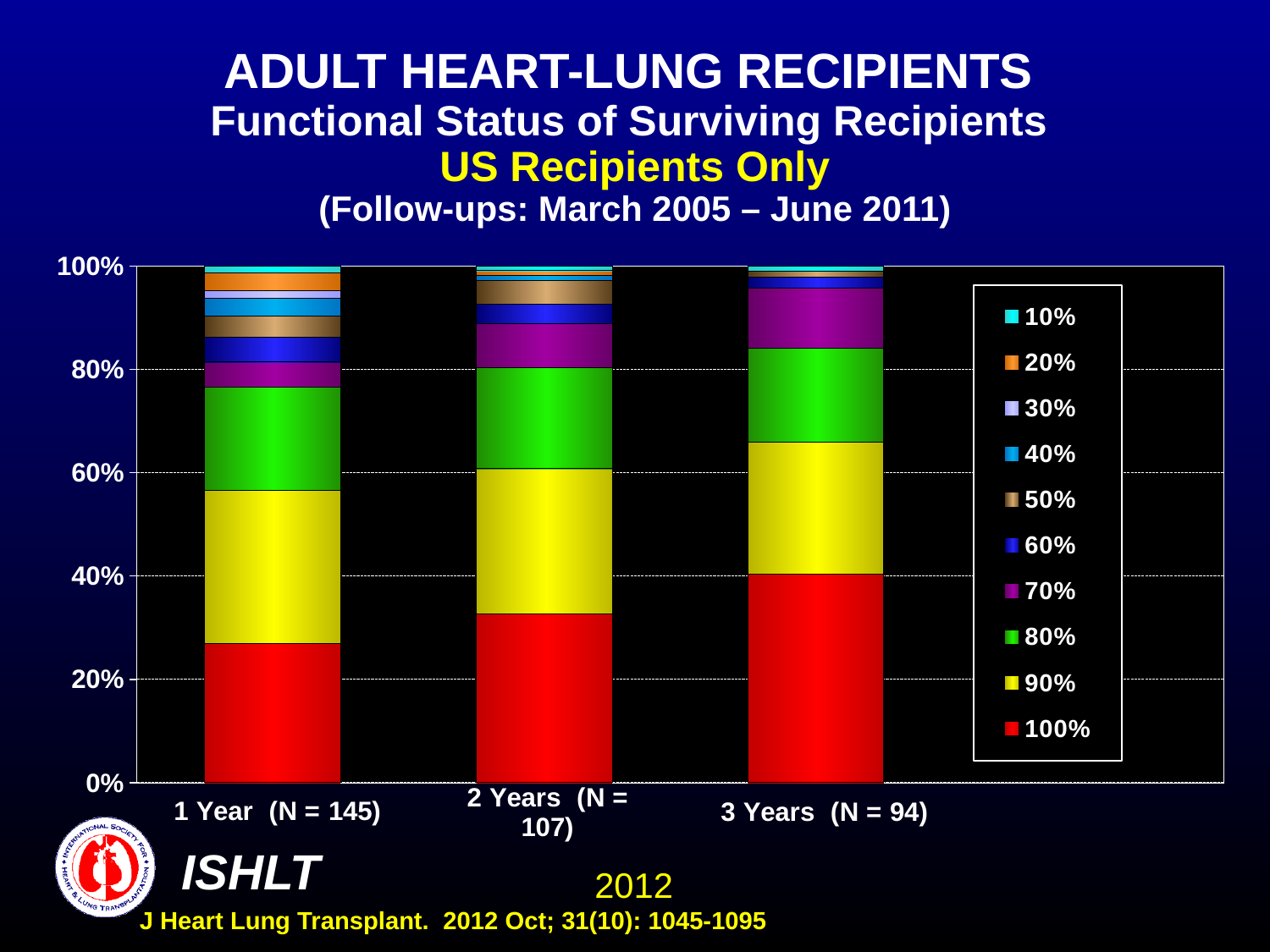
What is the N value shown for the 2 Years category? 107 What is the N value shown for the 3 Years category? 94 Is the 100% (red) segment larger for 1 Year or for 3 Years? 3 Years Is the share of the 100% (red) segment for 2 Years greater or less than 20%? greater Which category has the smallest 100% (red) segment? 1 Year Which category has the largest 100% (red) segment? 3 Years How many series does the legend list? 10 Does the 100% (red) segment rise or fall from 1 Year to 3 Years? rise Is the share of the 100% (red) segment for 1 Year greater or less than 40%? less Which legend entry is shown in red? 100% What kind of chart is shown on the slide? Stacked bar chart How many categories (time points) are shown on the x axis? 3